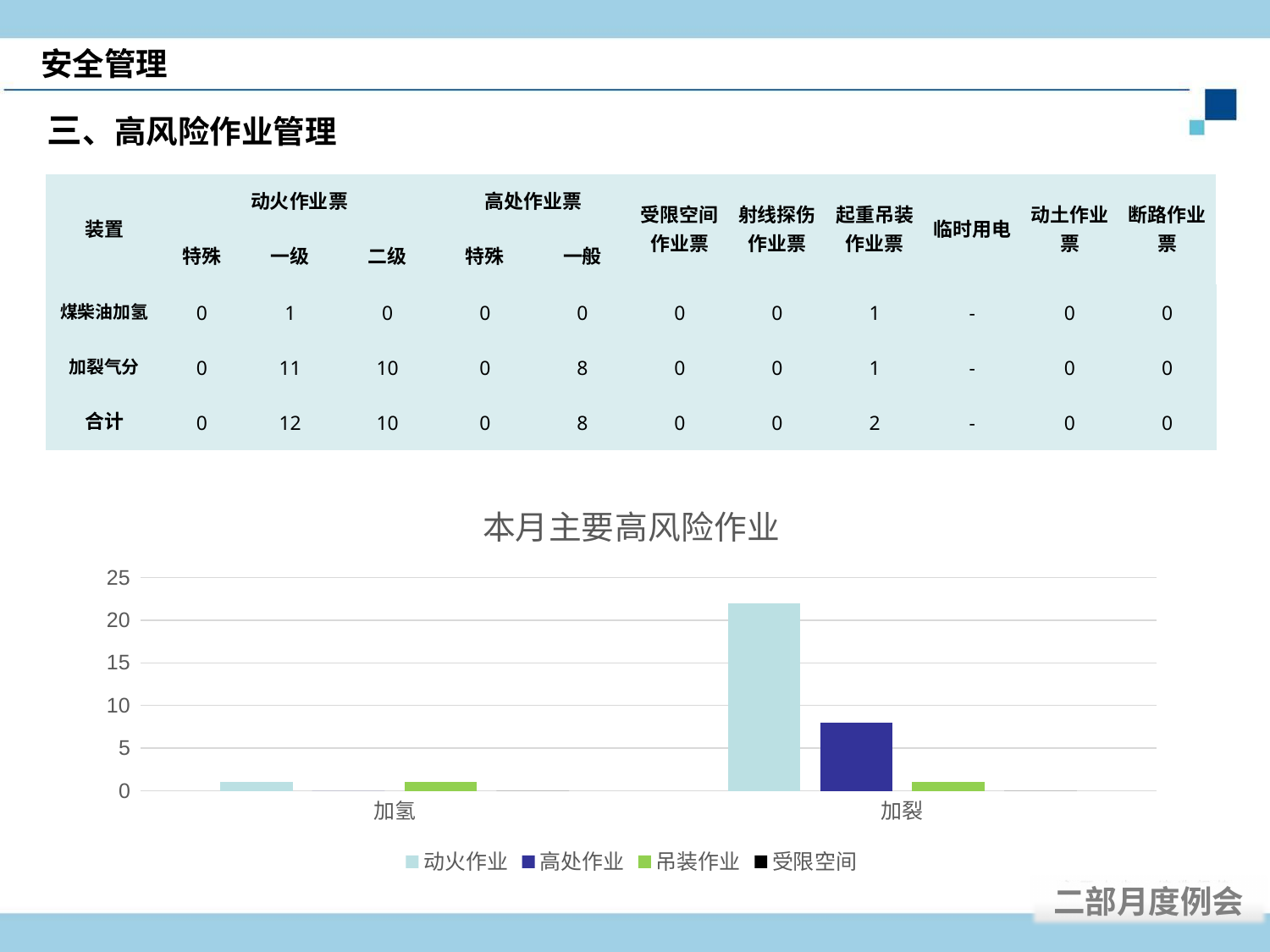
Which category has the higher value for 动火作业? 加裂 In the 加裂 category, which is larger: 高处作业 or 吊装作业? 高处作业 Is the value for 动火作业 in 加氢 greater or less than 5? less What is the title of the chart? 本月主要高风险作业 Is the value for 动火作业 in 加裂 greater or less than 15? greater How many categories are shown on the x axis of the chart? 2 What kind of chart is shown on the slide? bar chart How many series does the chart legend list? 4 Which series is shown in light blue in the chart legend? 动火作业 Which series has the highest value in the 加裂 category? 动火作业 Is the value for 高处作业 in 加裂 greater or less than 5? greater